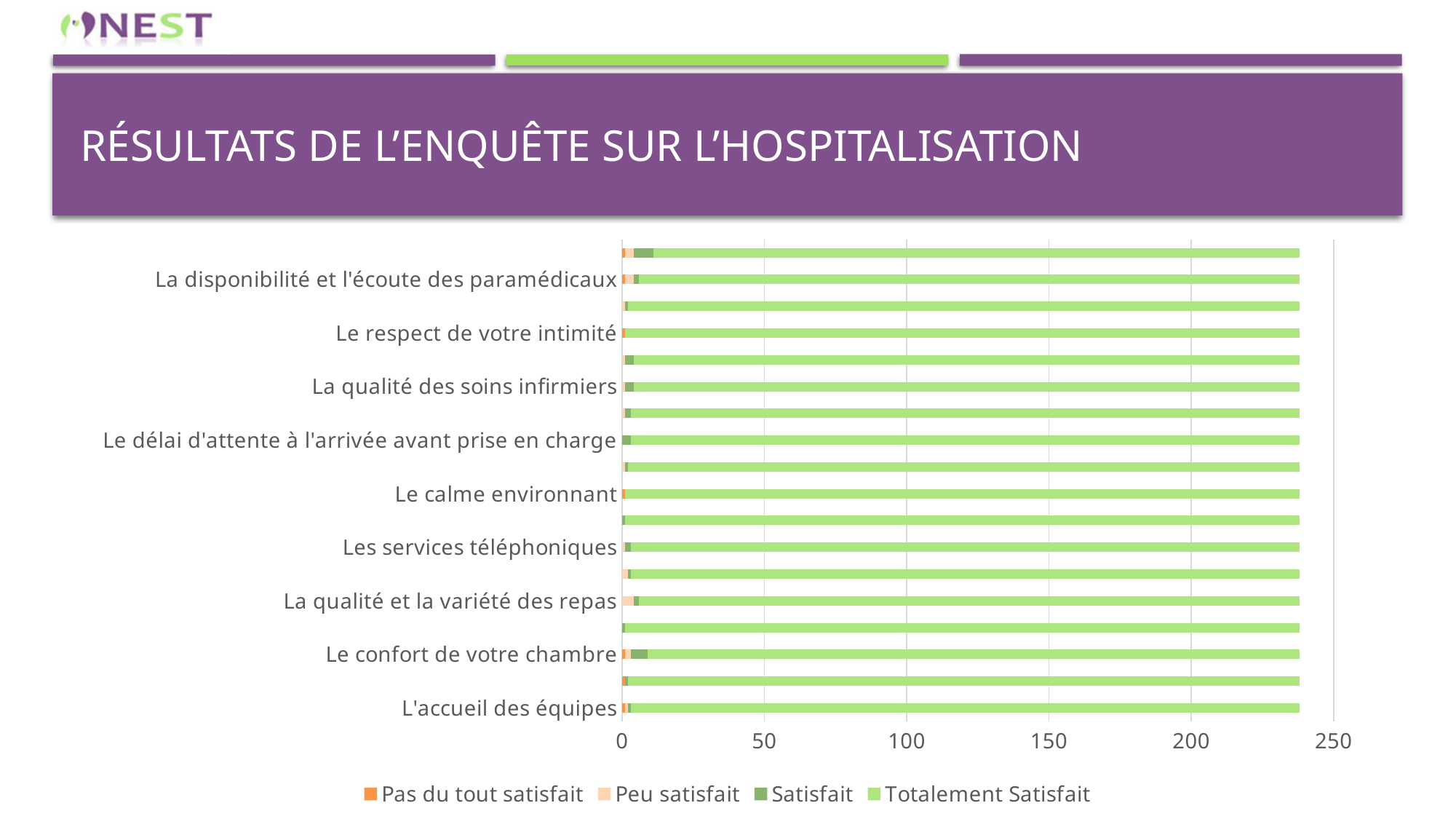
What kind of chart is shown on the slide? Stacked horizontal bar chart How many series does the legend list? 4 What is the highest value shown on the horizontal axis? 250 What is the title of the slide containing the chart? RÉSULTATS DE L'ENQUÊTE SUR L'HOSPITALISATION Which series makes up the largest part of every bar in the chart? Totalement Satisfait Is the "Satisfait" segment for "Le confort de votre chambre" greater or less than 50? less How many bars (categories) are plotted in the chart? 18 Is the total length of the bar for "Le respect de votre intimité" greater or less than 250? less Is the total length of the bar for "L'accueil des équipes" greater or less than 200? greater What are the four series listed in the legend? Pas du tout satisfait, Peu satisfait, Satisfait, Totalement Satisfait